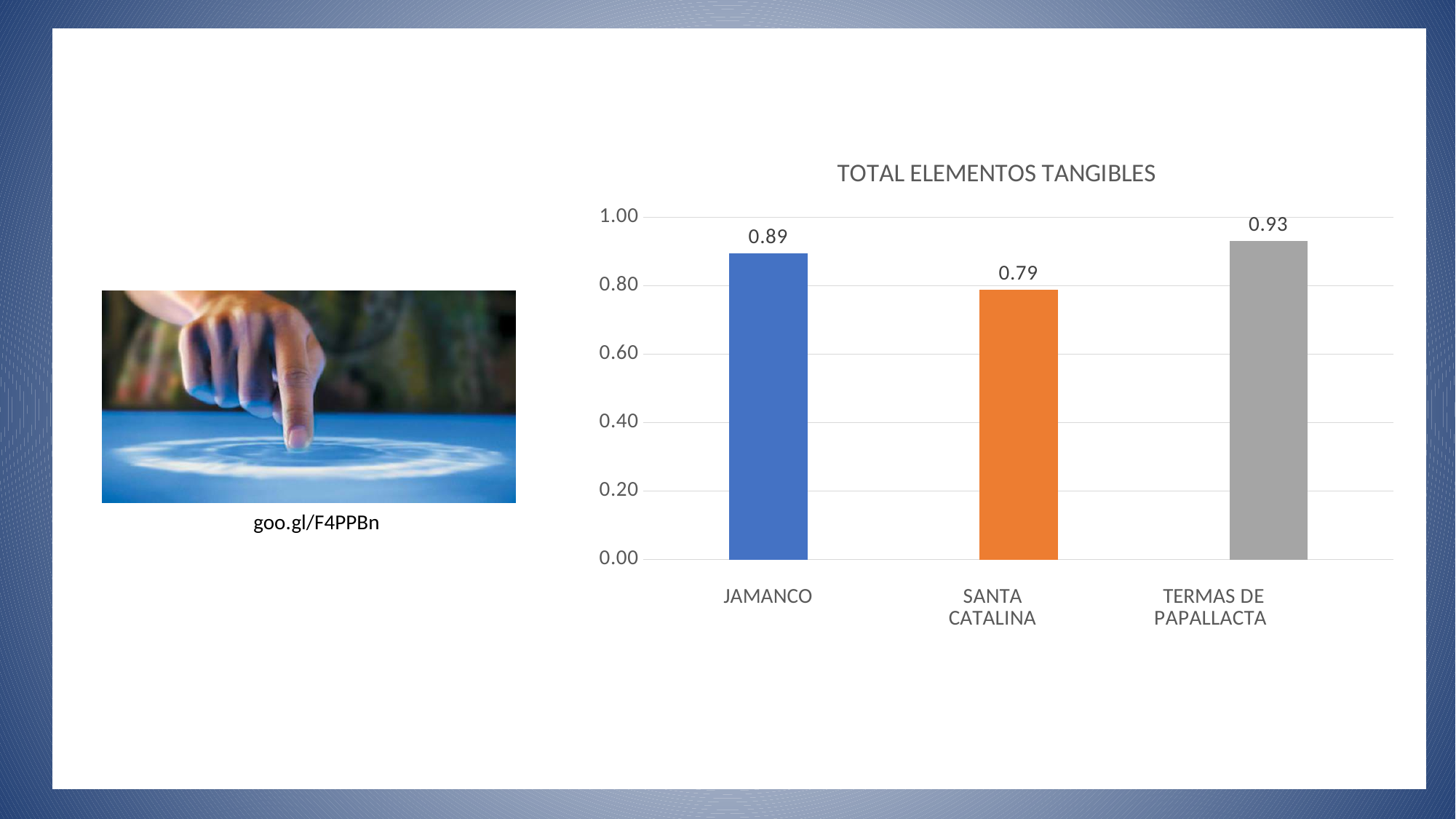
What is the value for TERMAS DE PAPALLACTA? 0.93 Is the value for SANTA CATALINA greater or less than 0.80? less Which category has the lowest value? SANTA CATALINA What is the difference between the values for JAMANCO and SANTA CATALINA? 0.10 Which category has the highest value? TERMAS DE PAPALLACTA How many categories are shown in the chart? 3 What is the difference between the values for TERMAS DE PAPALLACTA and SANTA CATALINA? 0.14 What is the value for JAMANCO? 0.89 What is the title of the chart? TOTAL ELEMENTOS TANGIBLES Which is larger, the value for JAMANCO or the value for SANTA CATALINA? JAMANCO What kind of chart is shown on the slide? bar chart What is the value for SANTA CATALINA? 0.79